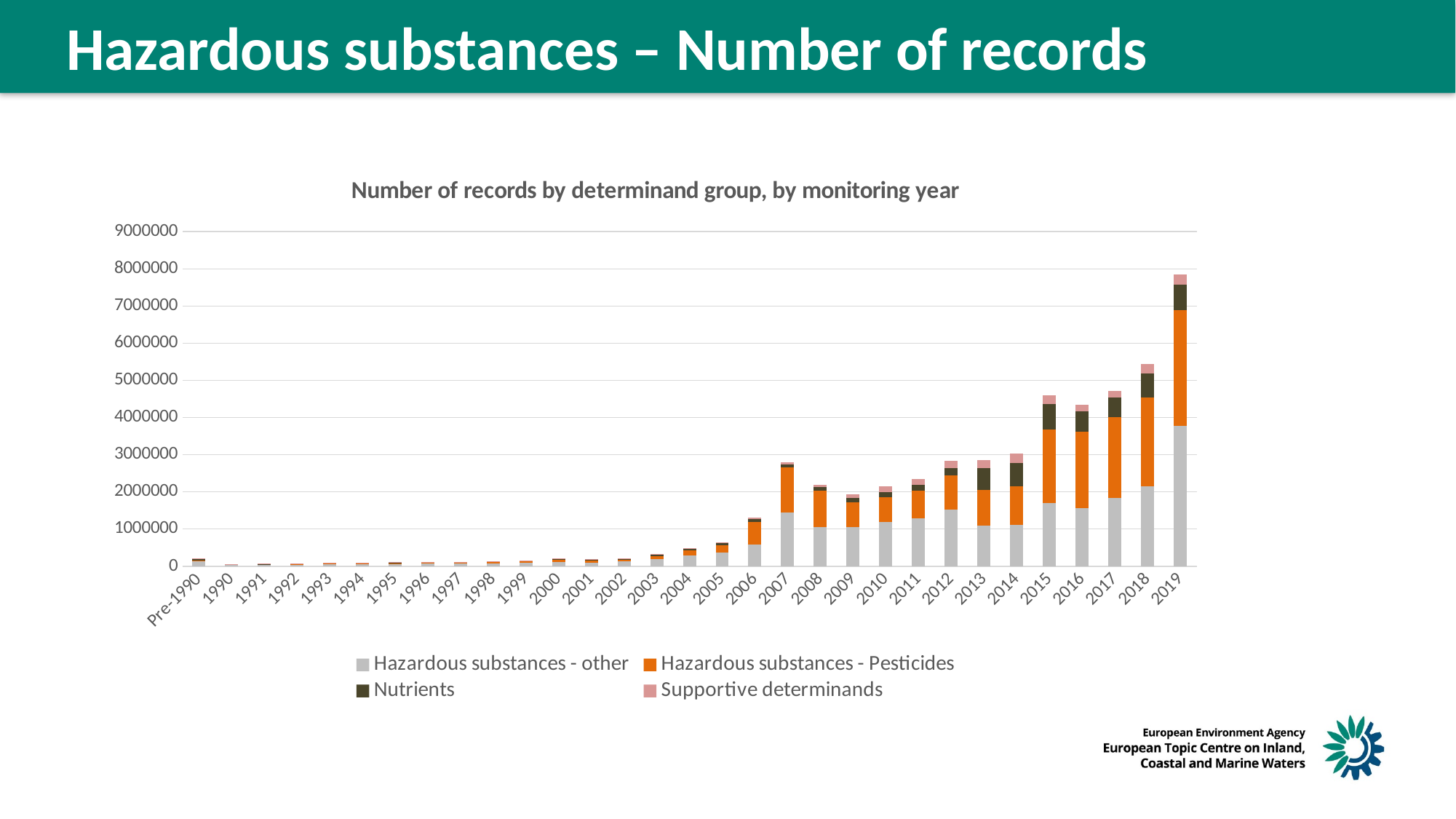
Is the total number of records for 2019 greater or less than 7000000? greater Is the total number of records for 2018 greater or less than 5000000? greater Is the total number of records for 2006 greater or less than 1000000? greater Between 2009 and 2015, do the total numbers of records generally rise or fall? rise How many monitoring-year categories are shown on the x axis? 31 What colour represents 'Hazardous substances - Pesticides' in the legend? Orange Which year has a larger total number of records, 2007 or 2008? 2007 What kind of chart is shown on the slide? Stacked bar chart Which monitoring year has the highest total number of records? 2019 How many series does the legend list? 4 Which year has a larger total number of records, 2017 or 2018? 2018